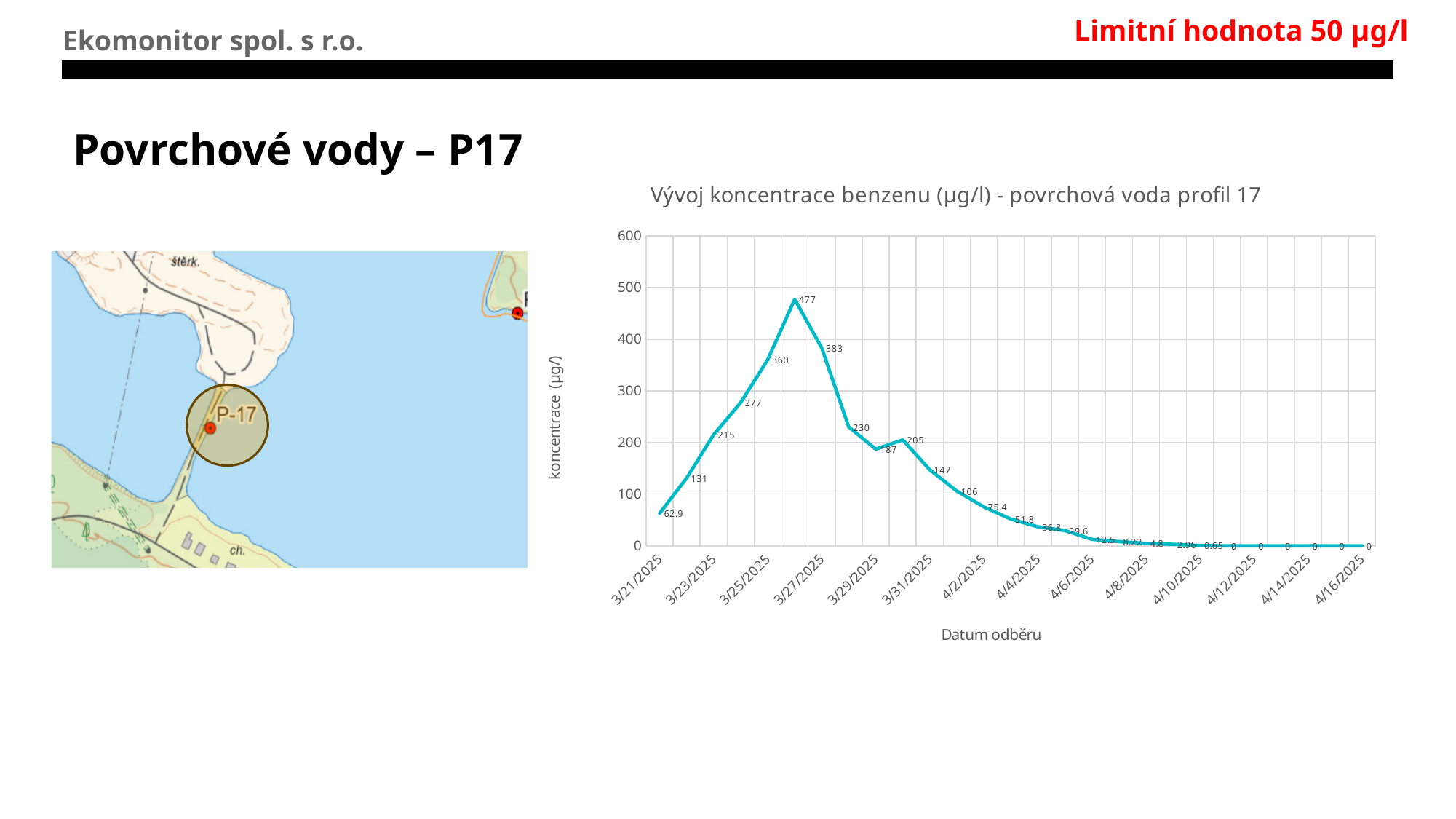
Do the values rise or fall along the x axis from 3/27/2025 to 4/16/2025? fall What is the value plotted for 3/23/2025? 215 Which date has the larger value, 3/25/2025 or 3/27/2025? 3/27/2025 What is the benzene concentration value on 3/21/2025? 62.9 What is the value plotted for 3/27/2025? 383 What is the value plotted for 4/2/2025? 75.4 What is the difference between the values for 3/27/2025 and 3/25/2025? 23 What is the highest value shown on the line? 477 What is the title of the chart? Vývoj koncentrace benzenu (µg/l) - povrchová voda profil 17 What is the label of the x axis of the chart? Datum odběru What type of chart is shown on the slide? line chart How many data points are plotted on the line? 27